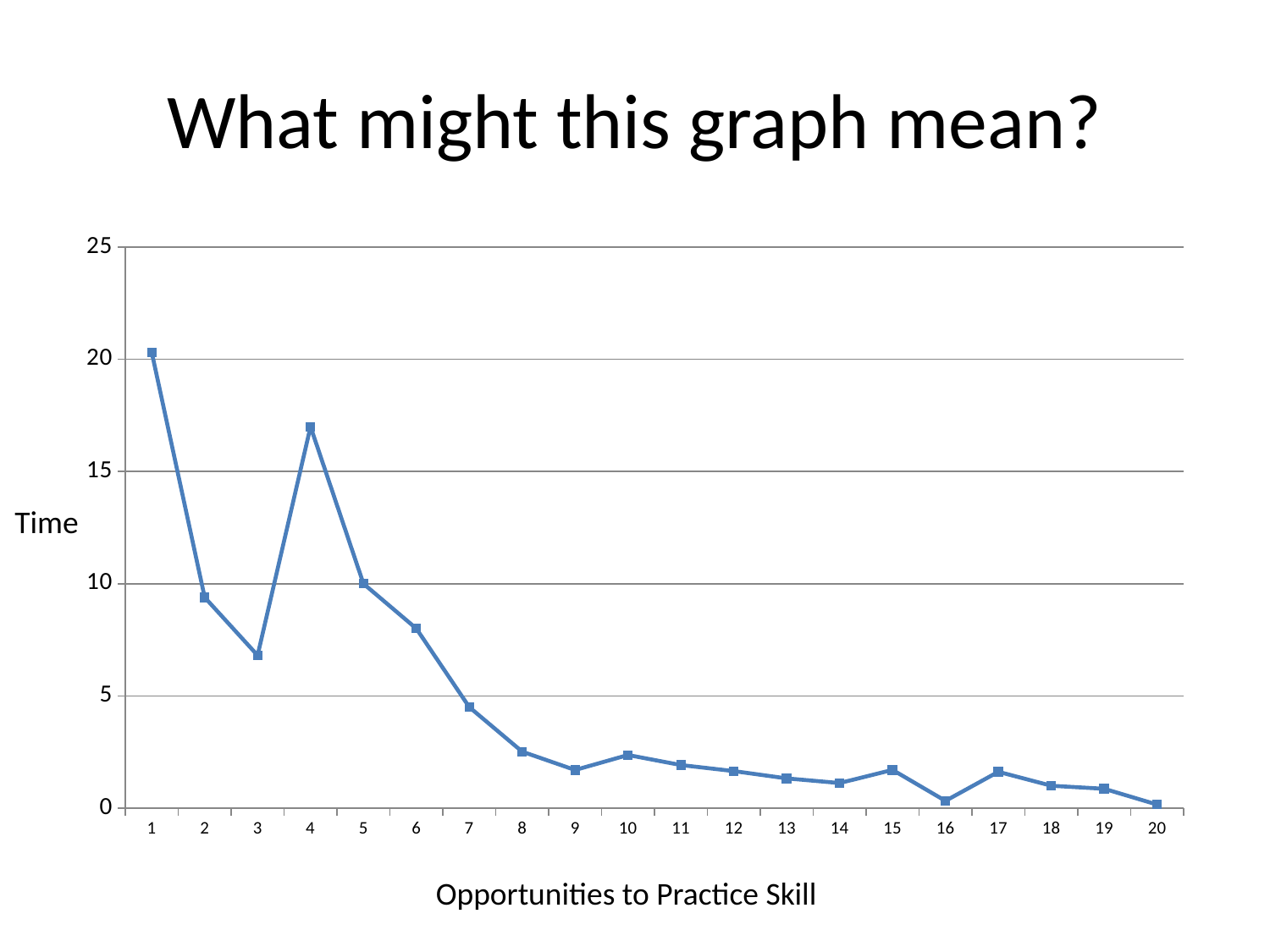
How many points are plotted along the x axis? 20 Which opportunity to practice skill has the lowest time value? 20 Is the value for opportunity 3 greater or less than 5? greater Which has the larger value, opportunity 2 or opportunity 4? 4 What kind of chart is shown on the slide? line chart Which opportunity to practice skill has the highest time value? 1 What is the label on the y axis? Time Overall, do the values rise or fall as the number of opportunities to practice the skill increases? fall Is the value for opportunity 4 greater or less than 15? greater Is the value for opportunity 7 greater or less than 5? less What is the label on the x axis? Opportunities to Practice Skill